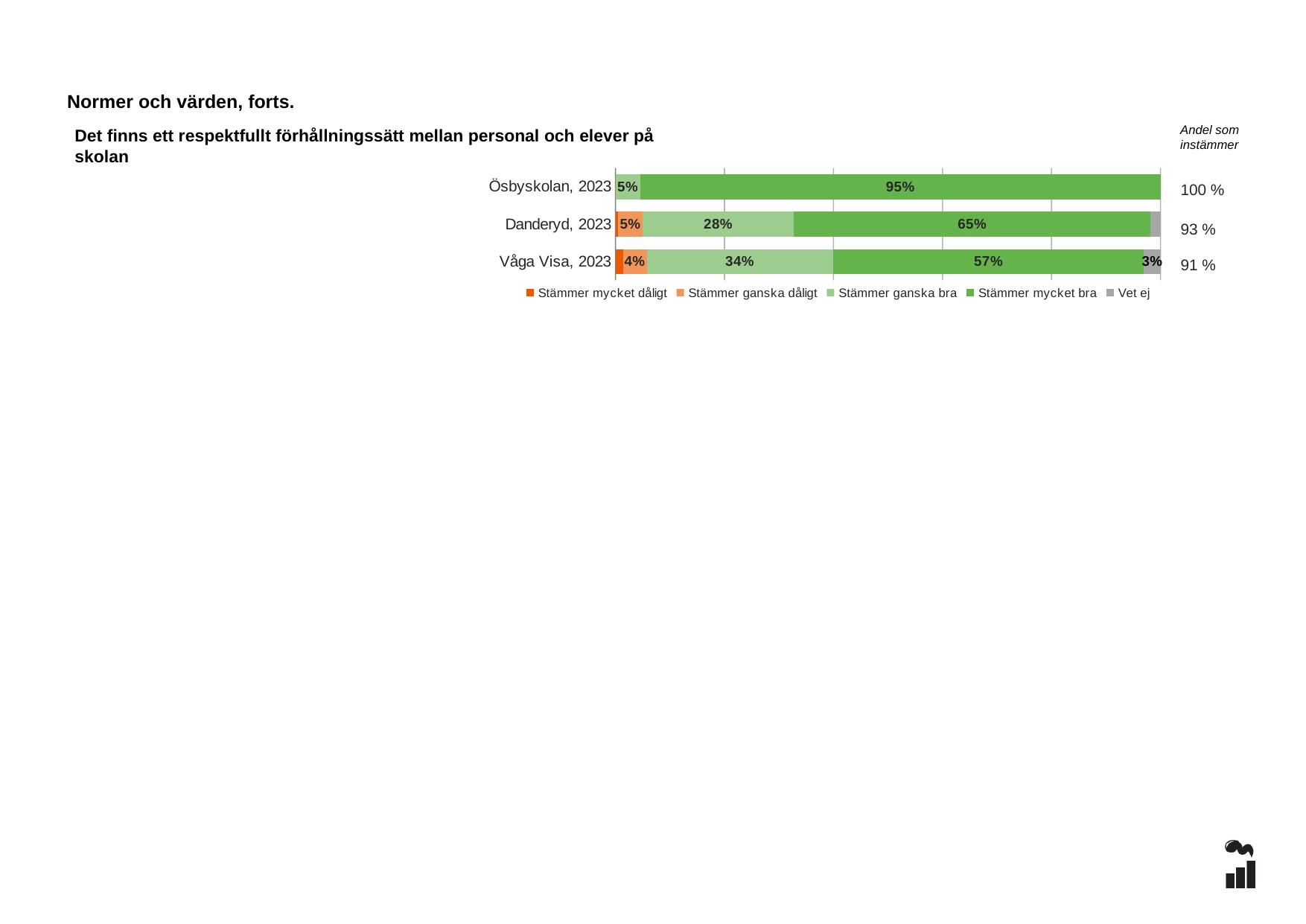
How many categories (bars) are shown in the chart? 3 What is the "Andel som instämmer" value shown for Danderyd, 2023? 93 % What percentage of Ösbyskolan, 2023 respondents answered "Stämmer mycket bra"? 95% Which category has the lowest "Andel som instämmer" value? Våga Visa, 2023 Which has a larger "Stämmer ganska bra" value, Danderyd, 2023 or Våga Visa, 2023? Våga Visa, 2023 What is the difference between the "Stämmer mycket bra" values for Ösbyskolan, 2023 and Danderyd, 2023? 30 percentage points What is the "Stämmer ganska bra" value for Danderyd, 2023? 28% What is the "Vet ej" value for Våga Visa, 2023? 3% What is the "Stämmer mycket bra" value for Våga Visa, 2023? 57% Which category has the highest "Stämmer mycket bra" value? Ösbyskolan, 2023 How many series does the legend list? 5 What kind of chart is shown on the slide? Stacked bar chart